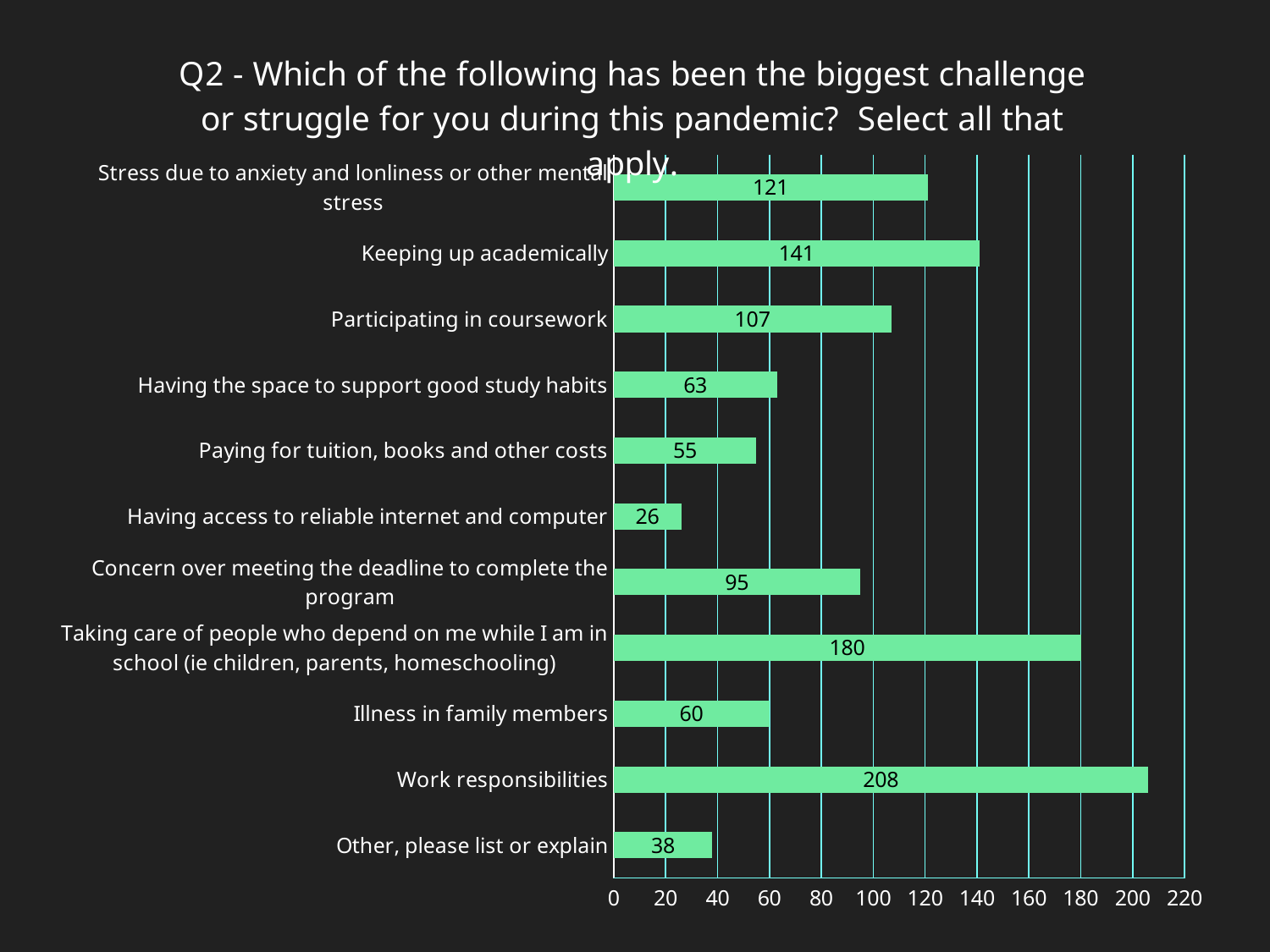
What is the value for Work responsibilities? 208 Which is larger: Participating in coursework or Concern over meeting the deadline to complete the program? Participating in coursework What is the highest value shown on the x axis? 220 What is the difference between the values for Work responsibilities and Taking care of people who depend on me while I am in school? 28 What is the value for Keeping up academically? 141 How many categories are shown in the chart? 11 What is the difference between the values for Having the space to support good study habits and Paying for tuition, books and other costs? 8 What kind of chart is shown on the slide? bar chart Which category has the highest value? Work responsibilities Is the value for Illness in family members greater or less than 80? less What is the value for Having access to reliable internet and computer? 26 Which category has the lowest value? Having access to reliable internet and computer